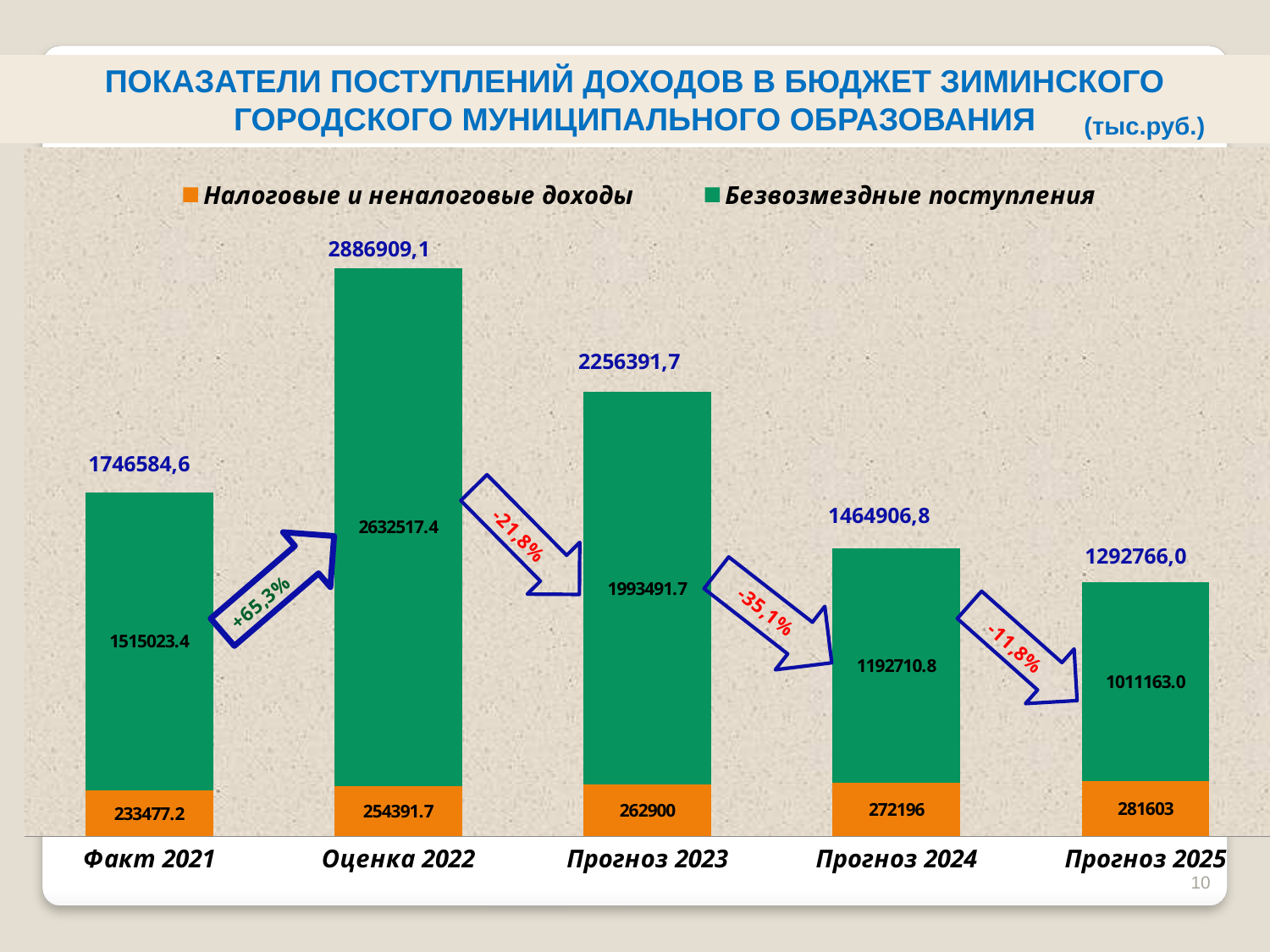
How many series does the legend list? 2 What is the total of the stacked bar for Прогноз 2023? 2256391,7 What is the difference between Налоговые и неналоговые доходы for Прогноз 2025 and for Прогноз 2024? 9407 What is the value of Налоговые и неналоговые доходы for Факт 2021? 233477.2 Which category has the lowest total? Прогноз 2025 What percentage change is shown on the arrow between Факт 2021 and Оценка 2022? +65,3% How many categories are shown on the x axis? 5 What is the value of Безвозмездные поступления for Оценка 2022? 2632517.4 What type of chart is shown on the slide? Stacked bar chart Which is larger: Безвозмездные поступления for Прогноз 2023 or for Прогноз 2024? Прогноз 2023 What is the value of Безвозмездные поступления for Прогноз 2025? 1011163.0 Which category has the highest total? Оценка 2022